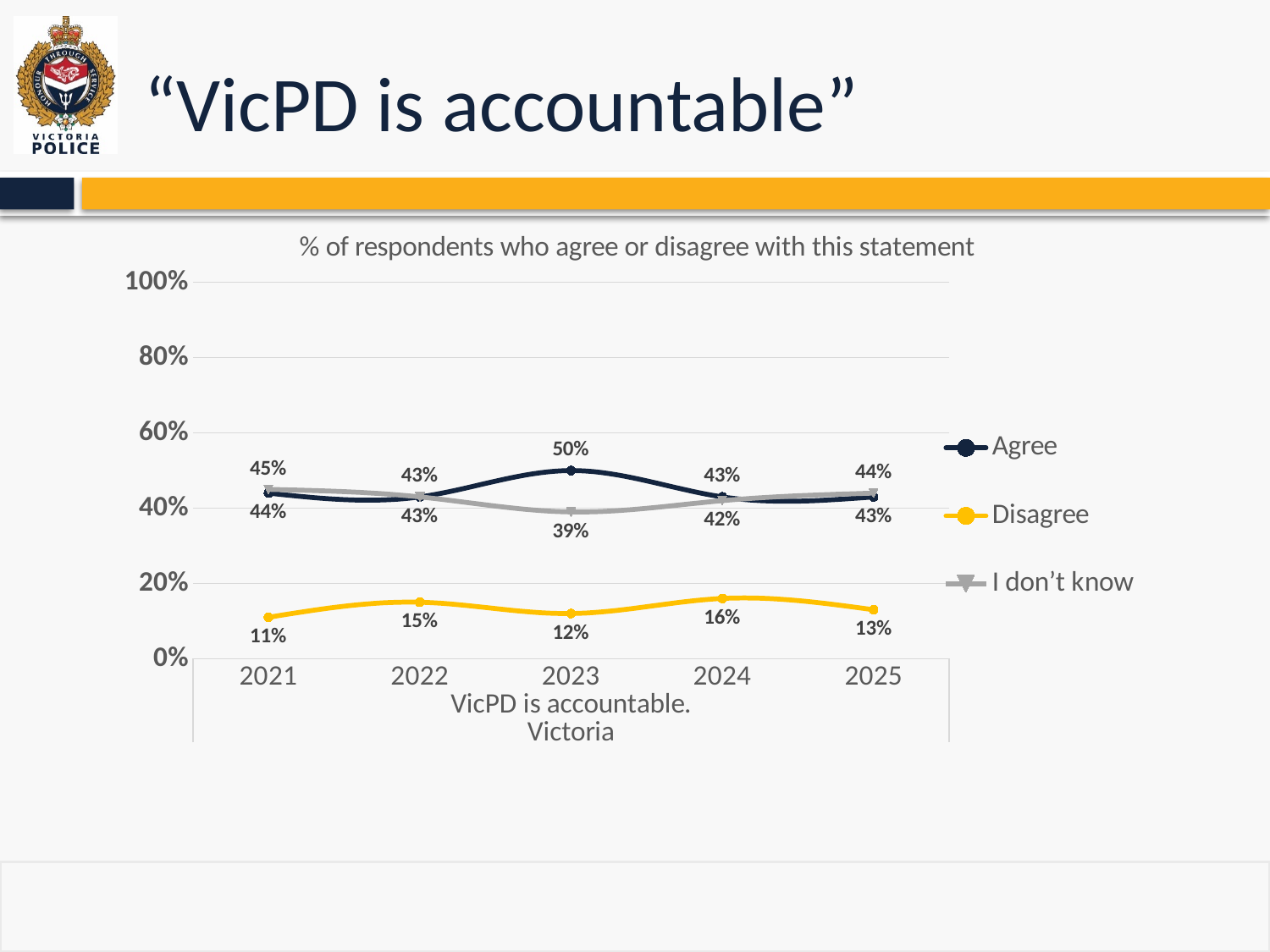
What was the Disagree value in 2024? 16% What percentage of respondents disagreed with the statement in 2021? 11% In 2024, which was larger: the Agree percentage or the Disagree percentage? Agree Is the Disagree value for 2022 greater or less than 20%? less What percentage of respondents answered 'I don't know' in 2023? 39% In which year was the Disagree percentage lowest? 2021 In which year was the Agree percentage highest? 2023 How many years are shown on the x axis? 5 What is the difference between the Agree and Disagree percentages in 2023? 38 percentage points How many series does the legend list? 3 What percentage of respondents agreed that VicPD is accountable in 2023? 50% What kind of chart is shown on the slide? Line chart